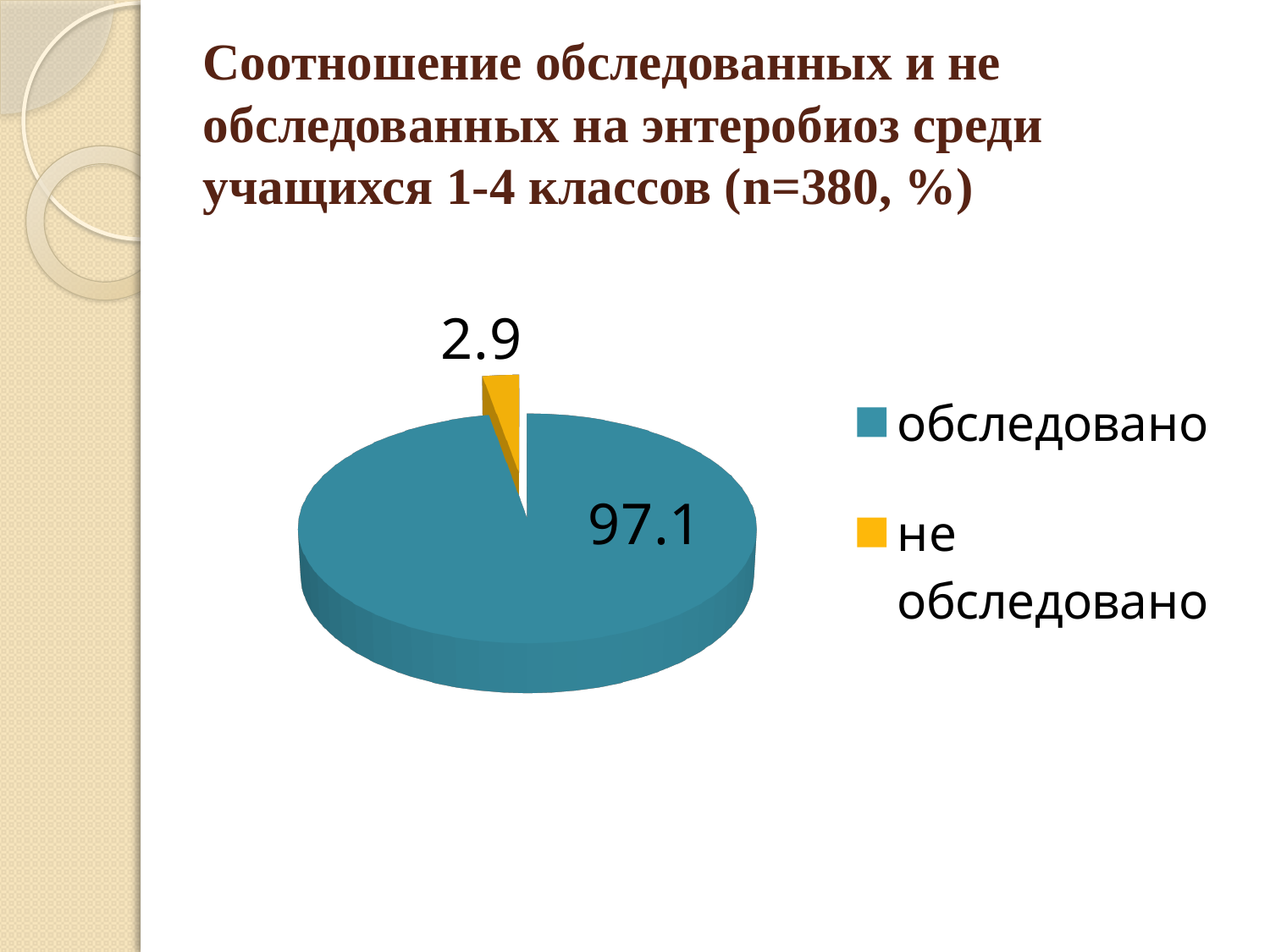
What is the difference between the values for "обследовано" and "не обследовано"? 94.2 Which category has the smallest slice? не обследовано What colour is the slice for "не обследовано"? yellow Which category has the largest slice? обследовано Which is larger, the value for "обследовано" or for "не обследовано"? обследовано What is the value for "не обследовано"? 2.9 What kind of chart is shown on the slide? pie chart What is the value for "обследовано"? 97.1 How many slices does the pie chart have? 2 What sample size (n) is given in the slide title? 380 How many entries does the legend list? 2